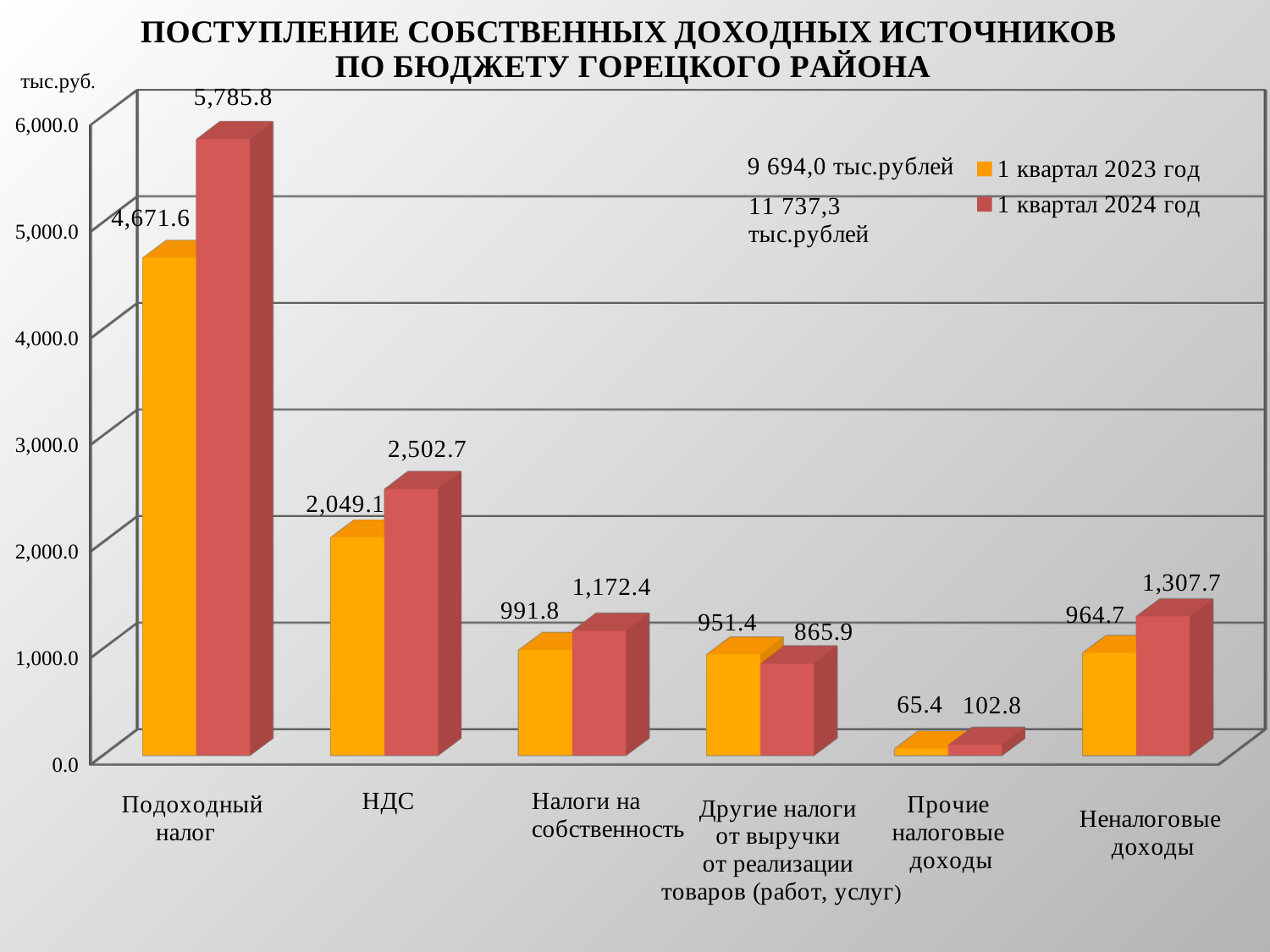
What is the value for Прочие налоговые доходы in 1 квартал 2024 год? 102.8 What kind of chart is shown on the slide? Bar chart Which category has the highest value in 1 квартал 2024 год? Подоходный налог What unit is indicated at the top of the vertical axis? тыс.руб. For Другие налоги от выручки от реализации товаров (работ, услуг), which is larger: the 1 квартал 2023 год value or the 1 квартал 2024 год value? 1 квартал 2023 год Which category has the lowest value in 1 квартал 2023 год? Прочие налоговые доходы How many categories are shown on the x axis? 6 What is the value for Неналоговые доходы in 1 квартал 2023 год? 964.7 What is the value for НДС in 1 квартал 2023 год? 2,049.1 What is the difference between the 1 квартал 2024 год and 1 квартал 2023 год values for Подоходный налог? 1,114.2 How many series does the legend list? 2 What is the value for Подоходный налог in 1 квартал 2024 год? 5,785.8